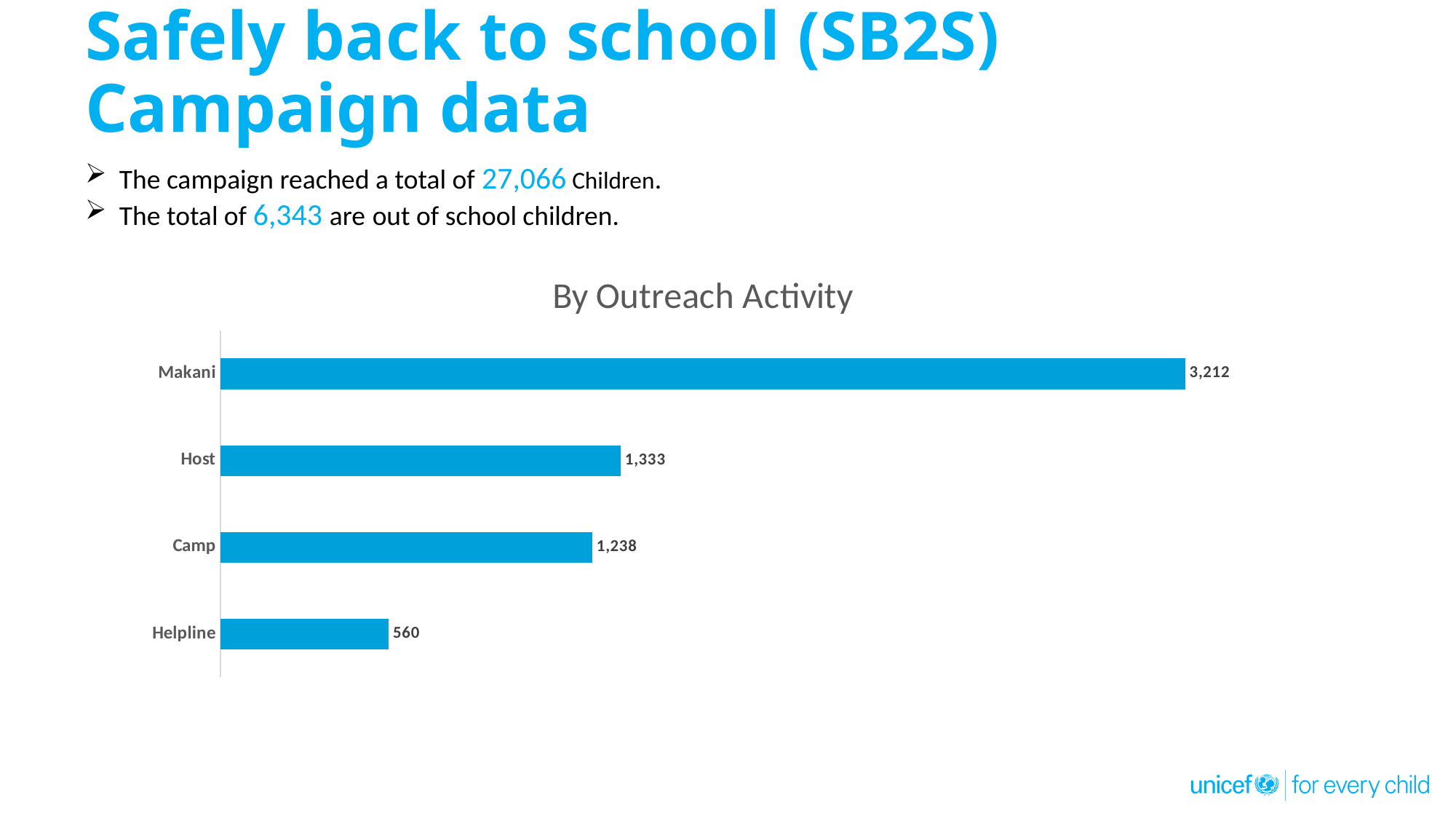
What is the value for Makani in the By Outreach Activity chart? 3,212 What is the difference between the values for Makani and Host? 1,879 What is the value for Camp in the By Outreach Activity chart? 1,238 What is the difference between the values for Host and Camp? 95 What is the value for Helpline in the By Outreach Activity chart? 560 How many outreach activities are shown in the chart? 4 What is the title of the chart on the slide? By Outreach Activity Which has a larger value, Camp or Helpline? Camp What kind of chart is shown on the slide? Bar chart Which outreach activity has the lowest value? Helpline What is the value for Host in the By Outreach Activity chart? 1,333 Which outreach activity has the highest value? Makani